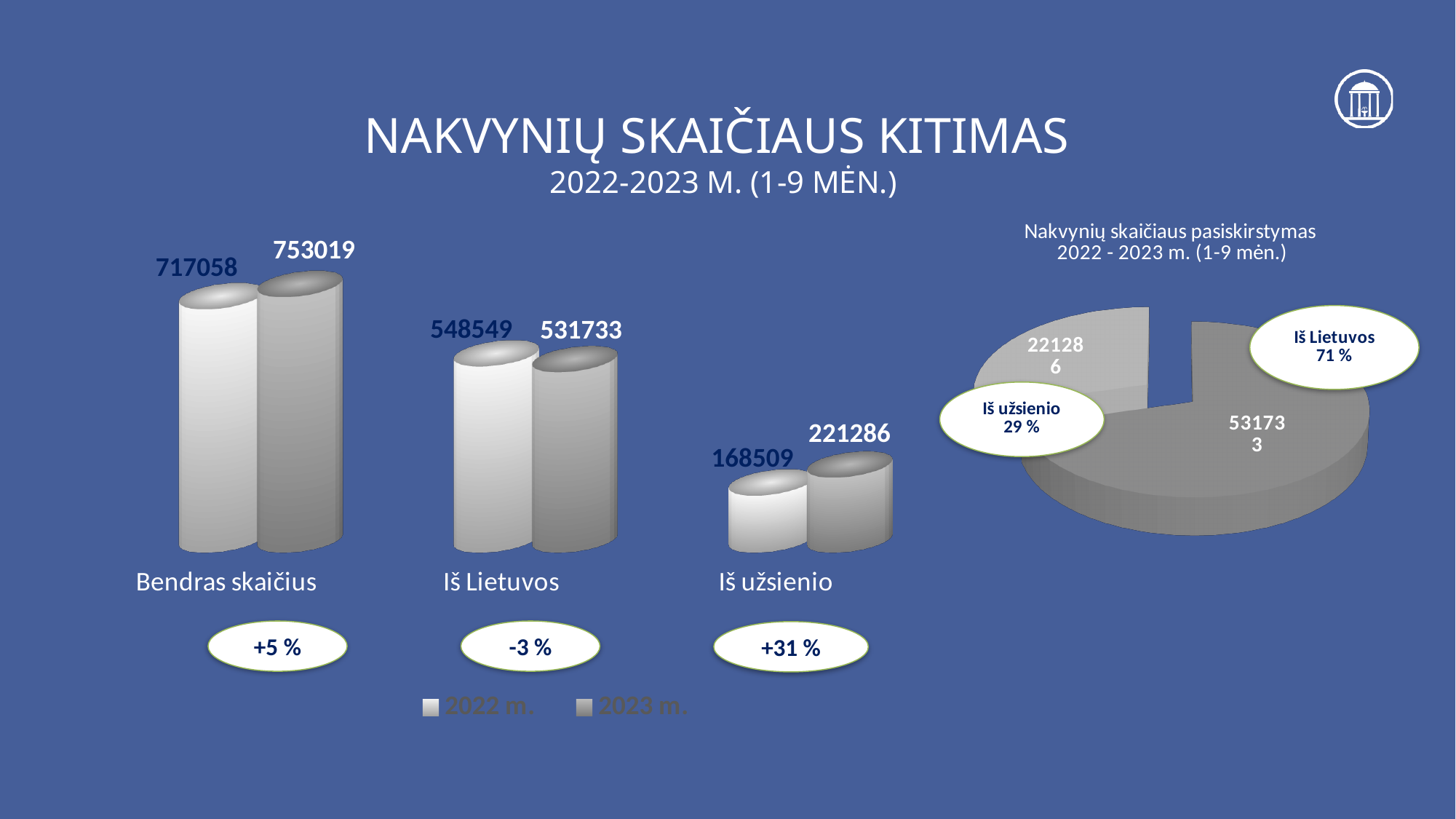
How many series does the legend of the bar chart on the left list? 2 In the pie chart on the right, what is the value shown for the Iš užsienio slice? 221286 In the bar chart on the left, what is the difference between the 2023 m. and 2022 m. values for Bendras skaičius? 35961 In the bar chart on the left, what is the value for Iš užsienio in 2023 m.? 221286 In the bar chart on the left, which is larger for Iš Lietuvos: the 2022 m. value or the 2023 m. value? 2022 m. What kind of chart is the chart on the right of the slide? Pie chart In the bar chart on the left, which category has the highest value in 2023 m.? Bendras skaičius In the bar chart on the left, which category has the lowest value in 2022 m.? Iš užsienio In the bar chart on the left, what is the value for Iš Lietuvos in 2022 m.? 548549 In the pie chart on the right, what share does Iš Lietuvos have? 71 % In the bar chart on the left, what is the value for Bendras skaičius in 2023 m.? 753019 How many categories does the bar chart on the left show? 3